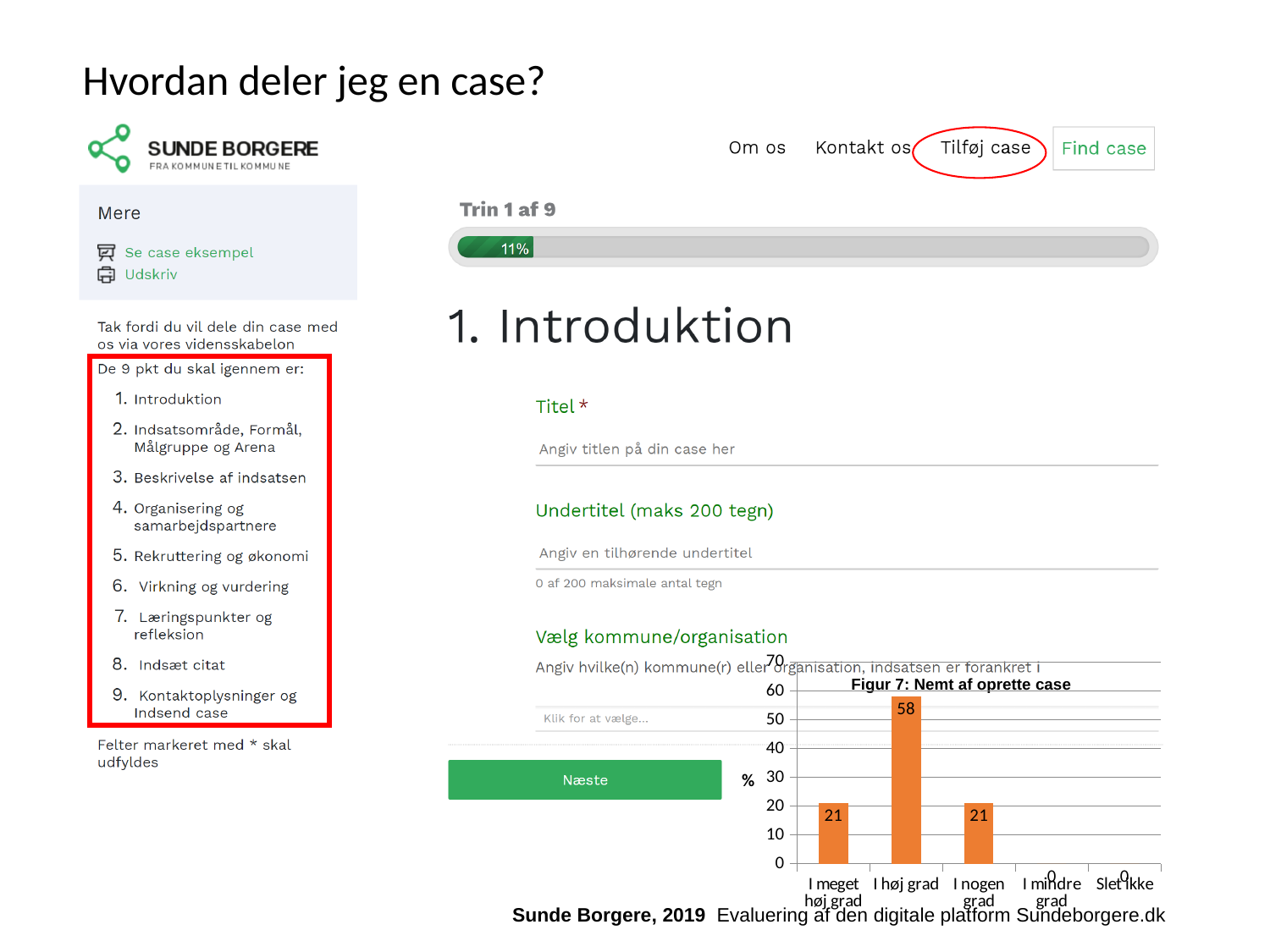
How many categories are shown on the x axis of the chart? 5 What is the value for 'I meget høj grad' in the chart? 21 Is the value for 'I høj grad' greater or less than 50? greater Which is larger, the value for 'I høj grad' or the value for 'I meget høj grad'? I høj grad What is the title of the chart on the slide? Figur 7: Nemt af oprette case What is the value for 'I høj grad' in the chart? 58 Which category has the highest value in the chart? I høj grad What is the label on the y axis of the chart? % What is the difference between the values for 'I høj grad' and 'I nogen grad'? 37 What is the value for 'I nogen grad' in the chart? 21 What is the value for 'Slet ikke' in the chart? 0 What type of chart is shown on the slide? bar chart